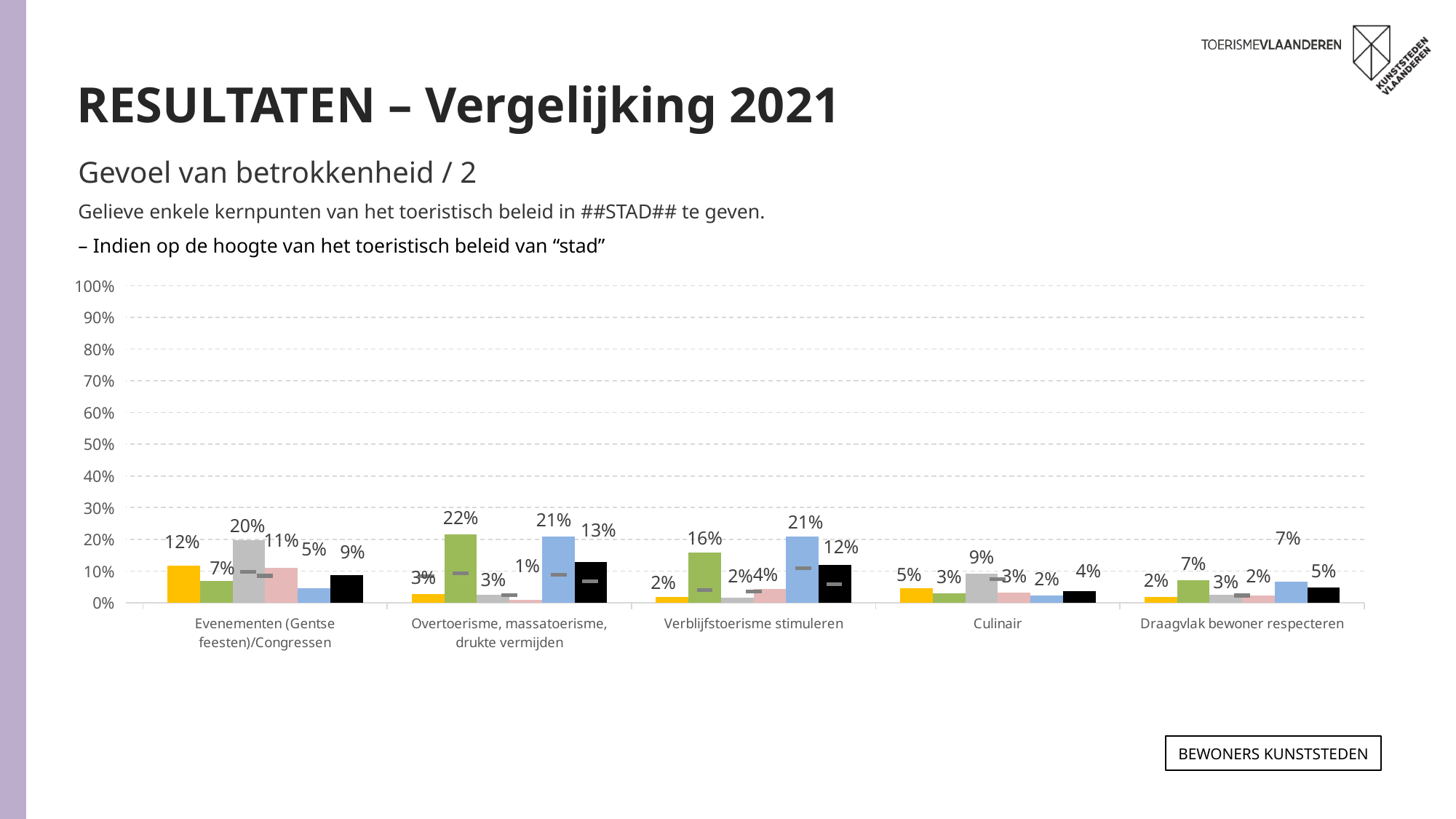
Is the value of the grey bar for Culinair greater or less than 10%? less What is the value of the blue bar for Verblijfstoerisme stimuleren? 21% What kind of chart is shown on the slide? bar chart How many categories are shown on the x axis of the chart? 5 Which category has the highest yellow bar? Evenementen (Gentse feesten)/Congressen What is the difference between the blue bar and the black bar for Overtoerisme, massatoerisme, drukte vermijden? 8% Which is larger for Verblijfstoerisme stimuleren: the green bar or the black bar? the green bar What is the value of the grey bar for Evenementen (Gentse feesten)/Congressen? 20% Which category has the lowest green bar? Culinair What is the value of the black bar for Culinair? 4% How many bars are shown for each category in the chart? 6 What is the value of the green bar for Overtoerisme, massatoerisme, drukte vermijden? 22%